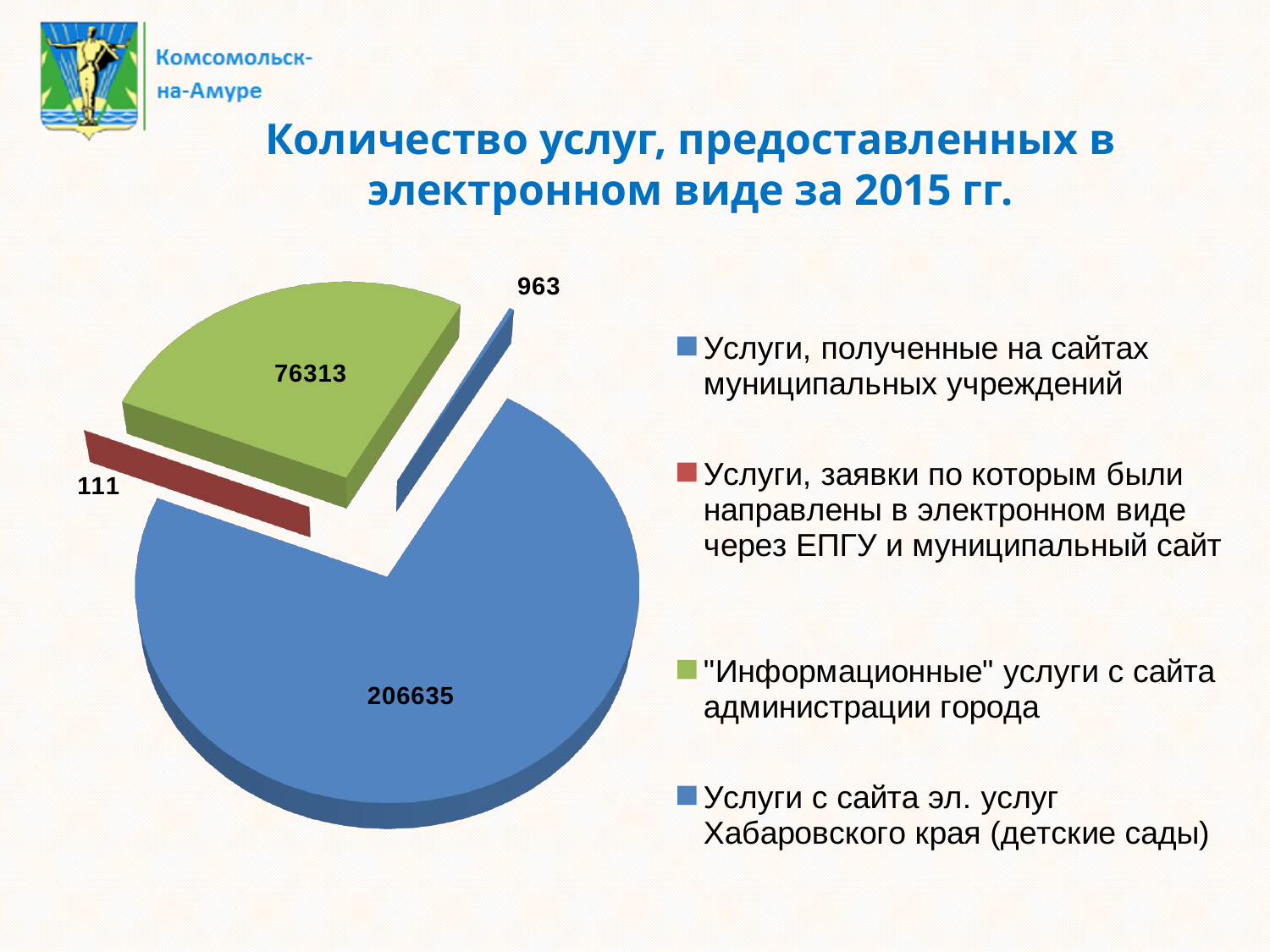
What is the value of the largest slice of the pie chart? 206635 What is the difference between the largest slice (206635) and the green slice (76313)? 130322 What is the value for Услуги, полученные на сайтах муниципальных учреждений? 206635 What is the value for "Информационные" услуги с сайта администрации города? 76313 What kind of chart is shown on the slide? Pie chart What is the value for Услуги, заявки по которым были направлены в электронном виде через ЕПГУ и муниципальный сайт? 111 What is the value for Услуги с сайта эл. услуг Хабаровского края (детские сады)? 963 What is the value of the smallest slice of the pie chart? 111 How many slices does the pie chart have? 4 What is the title of the chart on the slide? Количество услуг, предоставленных в электронном виде за 2015 гг. How many entries does the legend list? 4 Which is larger: the slice labelled 963 or the slice labelled 111? 963